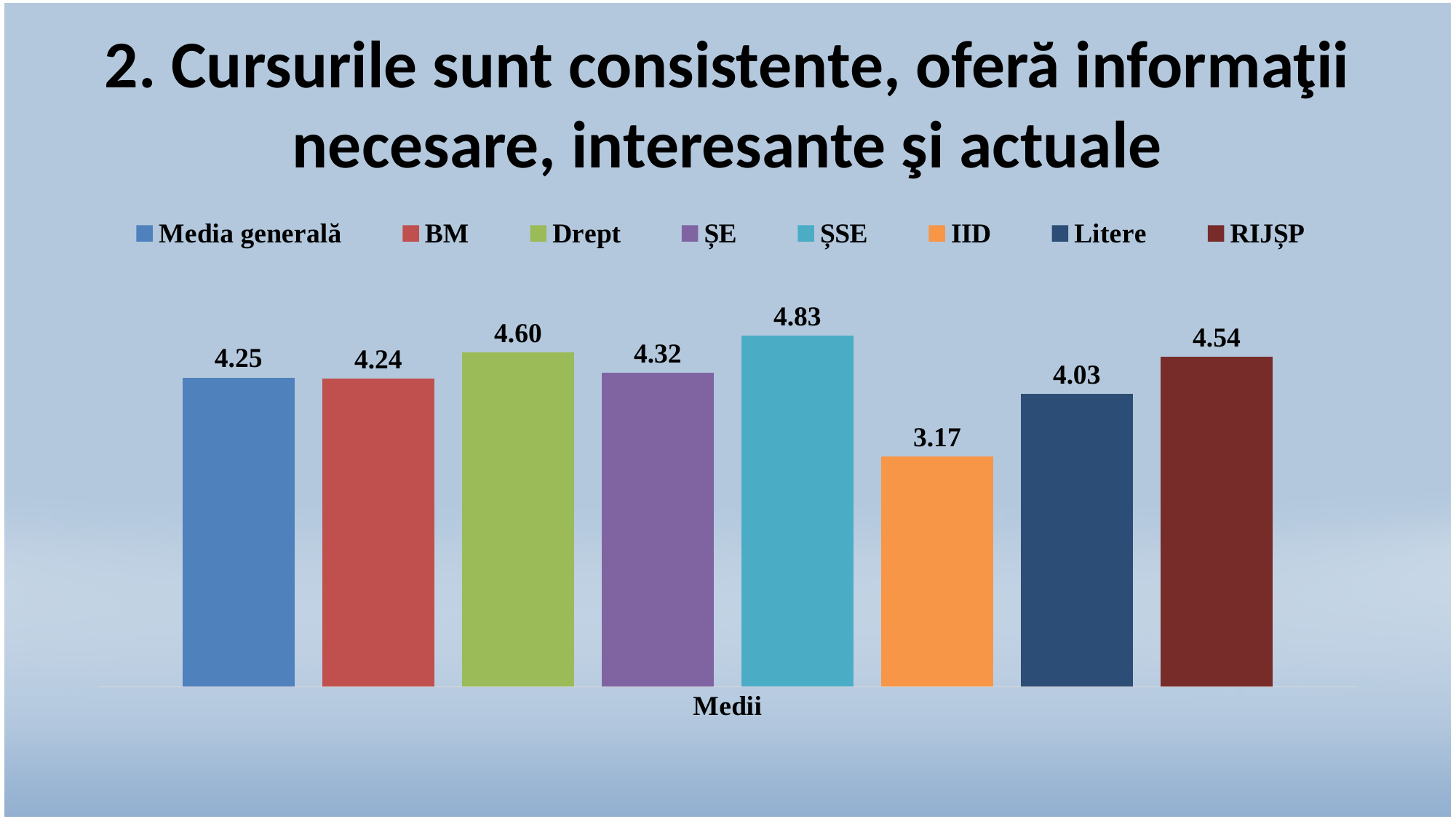
What is the label on the x axis of the chart? Medii What is the difference between the values for ȘSE and IID? 1.66 Which series has the highest value? ȘSE Which series has the lowest value? IID Which is larger, the value for Drept or the value for ȘE? Drept What is the value for ȘSE? 4.83 What is the value for Litere? 4.03 What is the value for IID? 3.17 What is the value for Media generală? 4.25 What kind of chart is shown on the slide? Bar chart What is the difference between the values for Drept and RIJȘP? 0.06 How many series does the legend list? 8